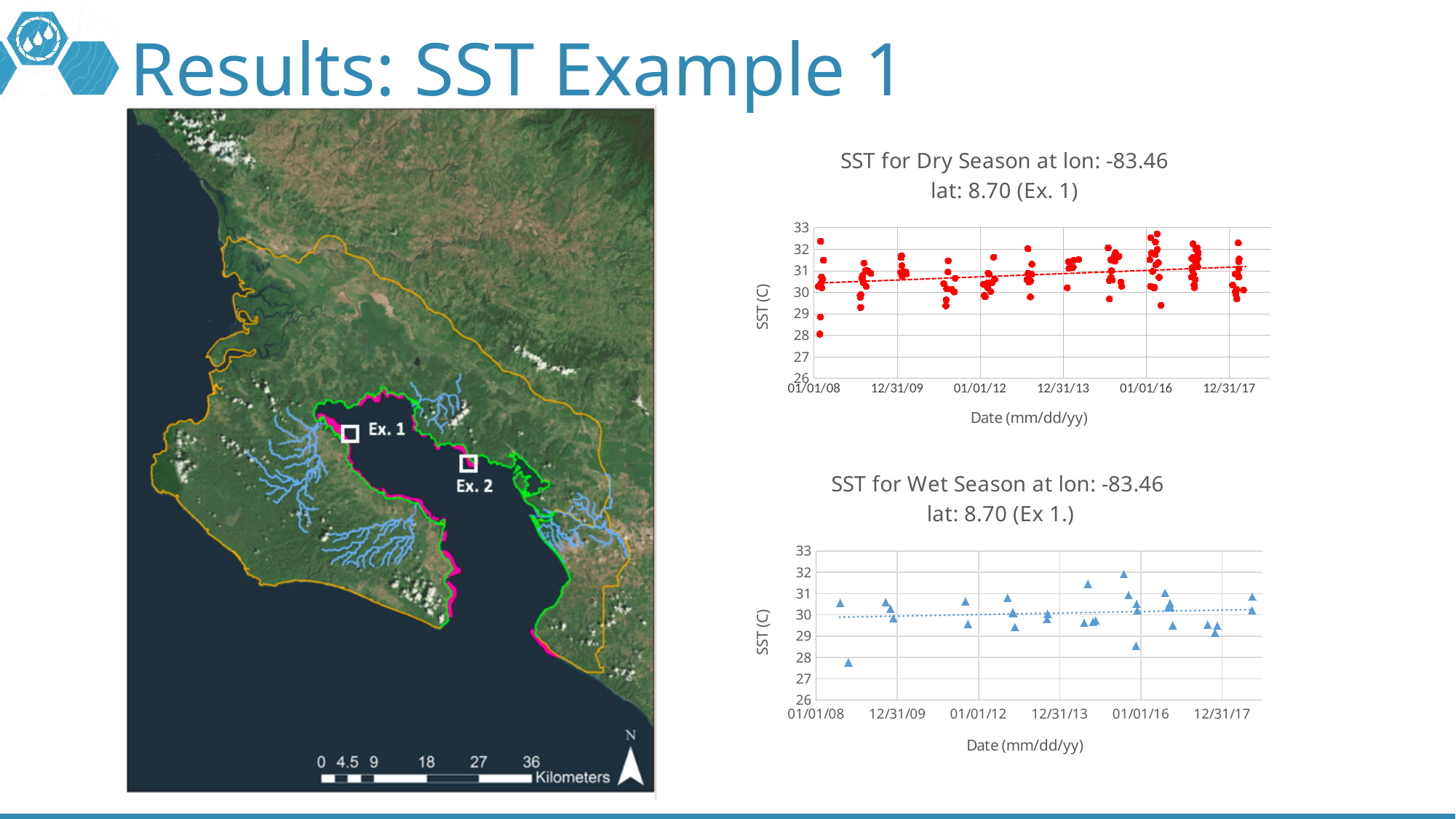
What is the y-axis label on the 'SST for Dry Season' chart? SST (C) What kind of chart is the 'SST for Wet Season' chart on the slide? scatter chart What is the maximum value shown on the y-axis of the 'SST for Wet Season' chart? 33 In the 'SST for Dry Season' chart, is the lowest plotted point greater or less than 27? greater What is the x-axis label on the 'SST for Wet Season' chart? Date (mm/dd/yy) What is the last date tick shown on the x-axis of the 'SST for Wet Season' chart? 12/31/17 In the 'SST for Dry Season' chart, does the dotted trend line rise or fall from left to right along the date axis? rise What kind of chart is the 'SST for Dry Season' chart on the slide? scatter chart What is the first date tick shown on the x-axis of the 'SST for Dry Season' chart? 01/01/08 In the 'SST for Wet Season' chart, is the highest plotted point (near 01/01/16) greater or less than 31? greater What is the minimum value shown on the y-axis of the 'SST for Dry Season' chart? 26 In the 'SST for Wet Season' chart, is the lowest plotted point (near 01/01/08) greater or less than 28? less